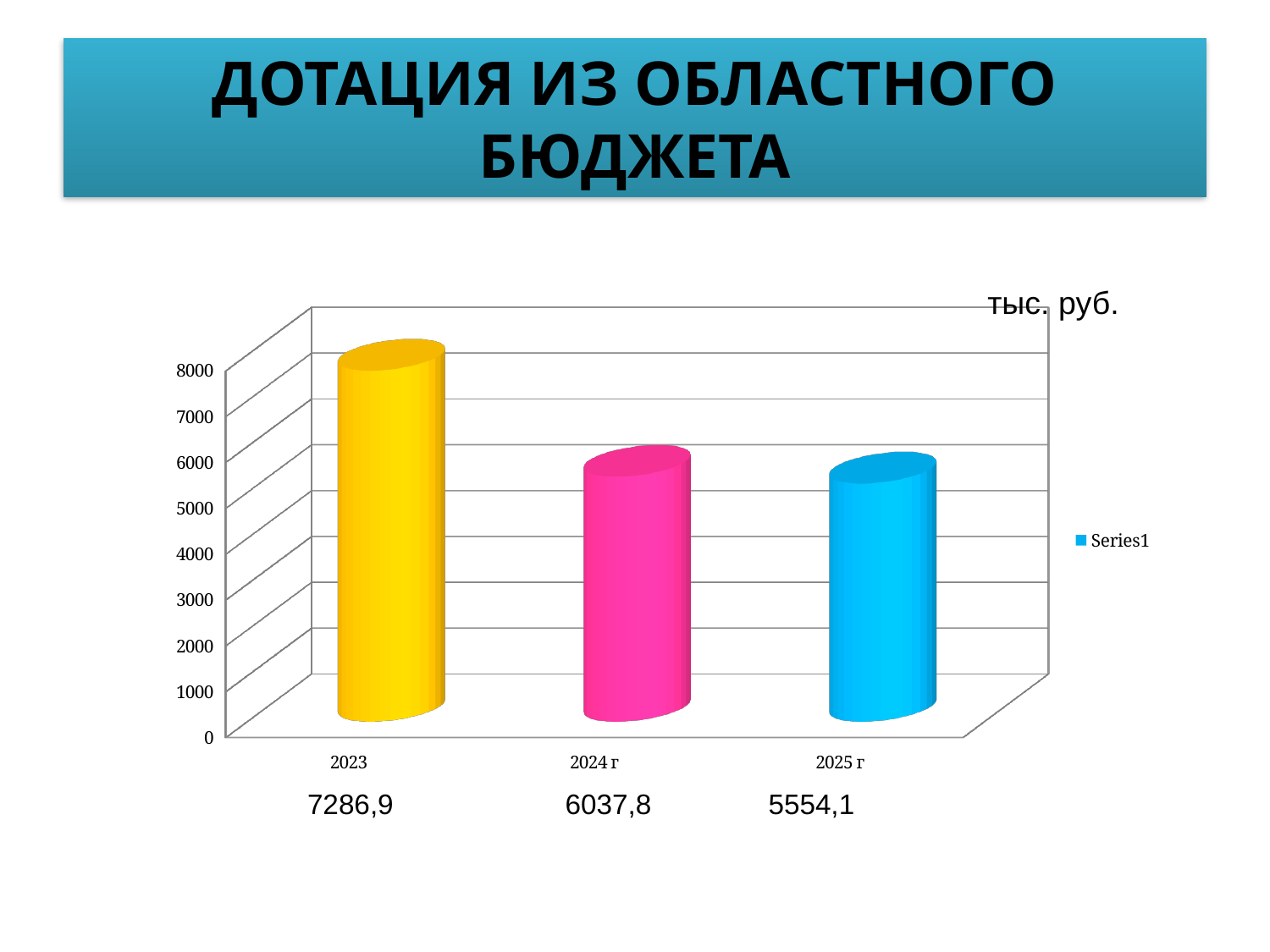
Which is larger, the value for 2024 г or the value for 2025 г? 2024 г What is the value for 2024 г? 6037,8 Which year has the highest value? 2023 What is the value for 2023? 7286,9 Is the value for 2025 г greater or less than 5000? greater What is the difference between the values for 2023 and 2024 г? 1249,1 Do the values rise or fall from 2023 to 2025 г? fall Which year has the lowest value? 2025 г What kind of chart is shown on the slide? bar chart What is the difference between the values for 2024 г and 2025 г? 483,7 What is the value for 2025 г? 5554,1 How many categories are shown on the x axis? 3